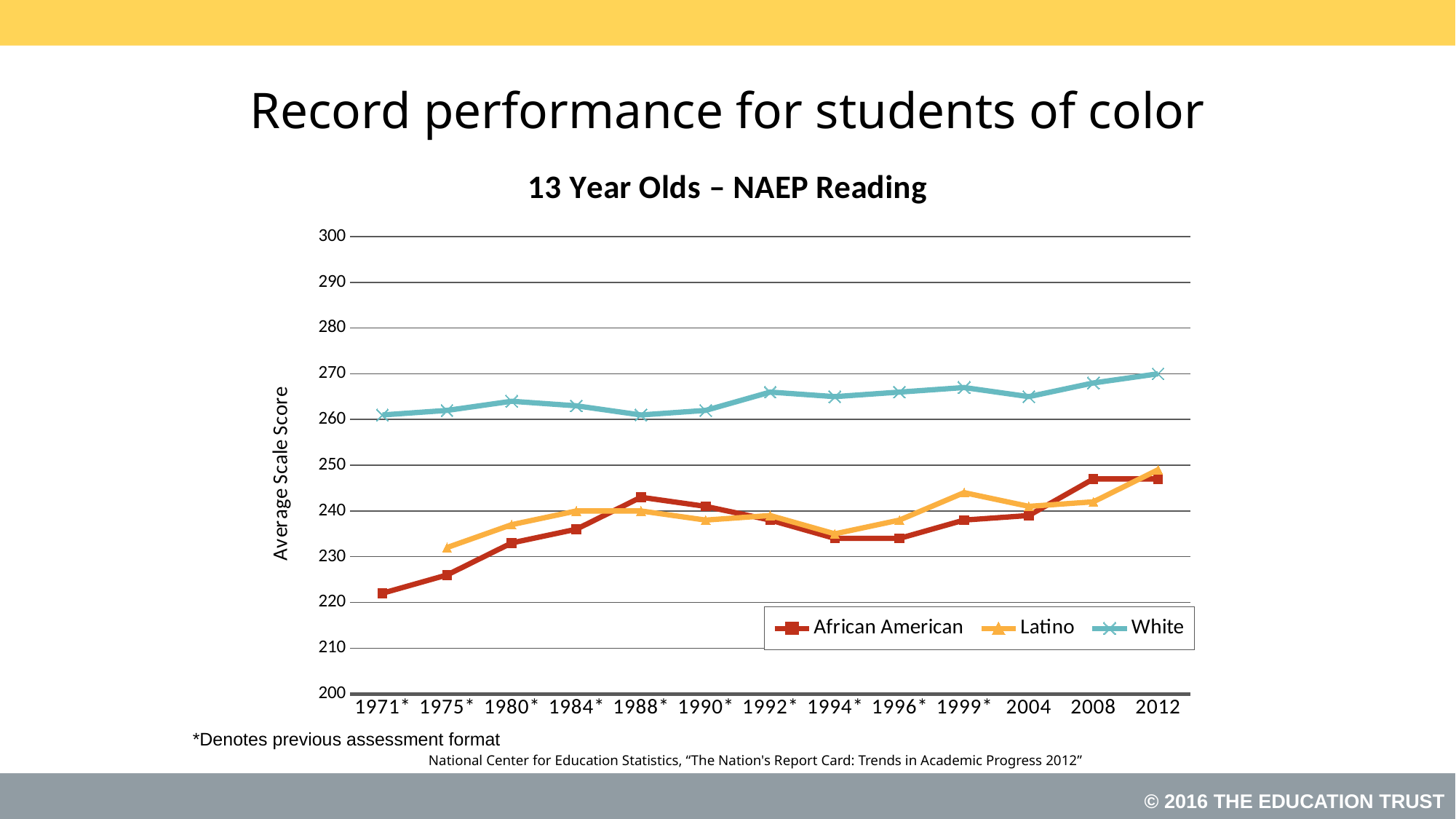
Is the Latino value for 1999* greater or less than 240? greater How many years are shown along the x axis? 13 What is the White average scale score in 2012? 270 What is the Latino average scale score in 1984*? 240 Does the White series rise or fall overall from 1971* to 2012? rise How many series does the legend list? 3 Which series has the highest value in 2012? White What kind of chart is shown on the slide? line chart In which year is the African American series at its lowest? 1971* What is the label on the y axis? Average Scale Score Is the African American value for 1971* greater or less than 230? less